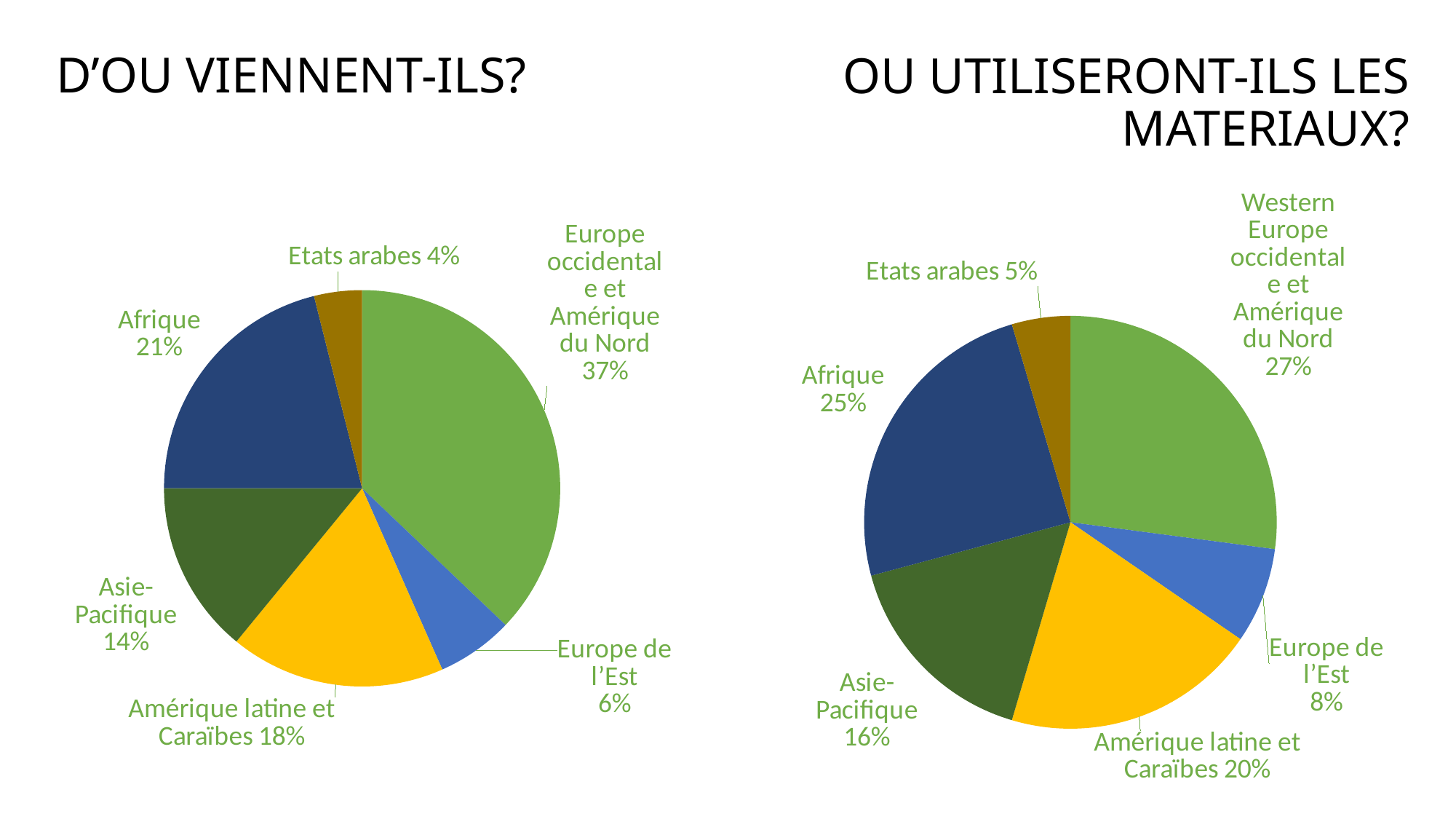
What type of chart is shown on the right (OU UTILISERONT-ILS LES MATERIAUX?)? Pie chart In the right pie chart (OU UTILISERONT-ILS LES MATERIAUX?), what share does Amérique latine et Caraïbes have? 20% In the left pie chart (D'OU VIENNENT-ILS?), which category has the largest share? Europe occidentale et Amérique du Nord What is the title of the left pie chart? D'OU VIENNENT-ILS? In the right pie chart (OU UTILISERONT-ILS LES MATERIAUX?), which category has the smallest share? Etats arabes In the left pie chart (D'OU VIENNENT-ILS?), what share does Afrique have? 21% In the right pie chart (OU UTILISERONT-ILS LES MATERIAUX?), which is larger: the share of Afrique or the share of Asie-Pacifique? Afrique How many slices does the left pie chart (D'OU VIENNENT-ILS?) have? 6 In the left pie chart (D'OU VIENNENT-ILS?), what is the difference between the shares of Afrique and Asie-Pacifique? 7% In the right pie chart (OU UTILISERONT-ILS LES MATERIAUX?), what share does Western Europe occidentale et Amérique du Nord have? 27% In the left pie chart (D'OU VIENNENT-ILS?), what share does Europe de l'Est have? 6% In the right pie chart (OU UTILISERONT-ILS LES MATERIAUX?), what is the difference between the shares of Europe de l'Est and Etats arabes? 3%